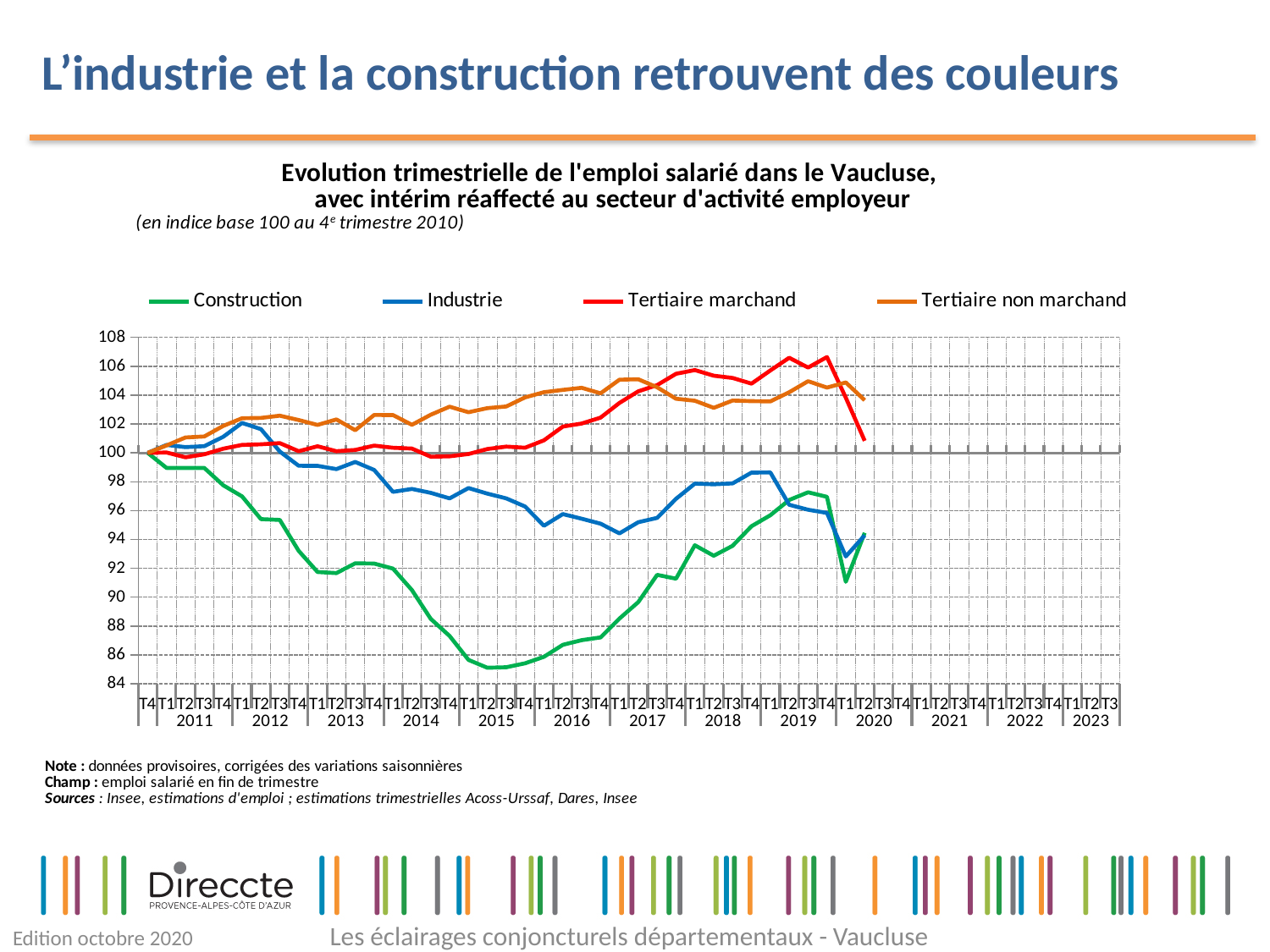
Is the value for Industrie at T1 2020 greater or less than 94? less Which series are listed in the legend? Construction, Industrie, Tertiaire marchand, Tertiaire non marchand What is the title of the chart? Evolution trimestrielle de l'emploi salarié dans le Vaucluse, avec intérim réaffecté au secteur d'activité employeur Is the value for Construction at T2 2015 greater or less than 86? less Is the value for Tertiaire marchand at T2 2020 greater or less than 102? less How many series does the legend list? 4 Which series has the highest value at T4 2019? Tertiaire marchand What index value do all series have at T4 2010? 100 What kind of chart is shown on the slide? line chart Which series has the highest values during 2016? Tertiaire non marchand Does the Construction series rise or fall between T4 2010 and T2 2015? fall Which series has the lowest values during 2015? Construction